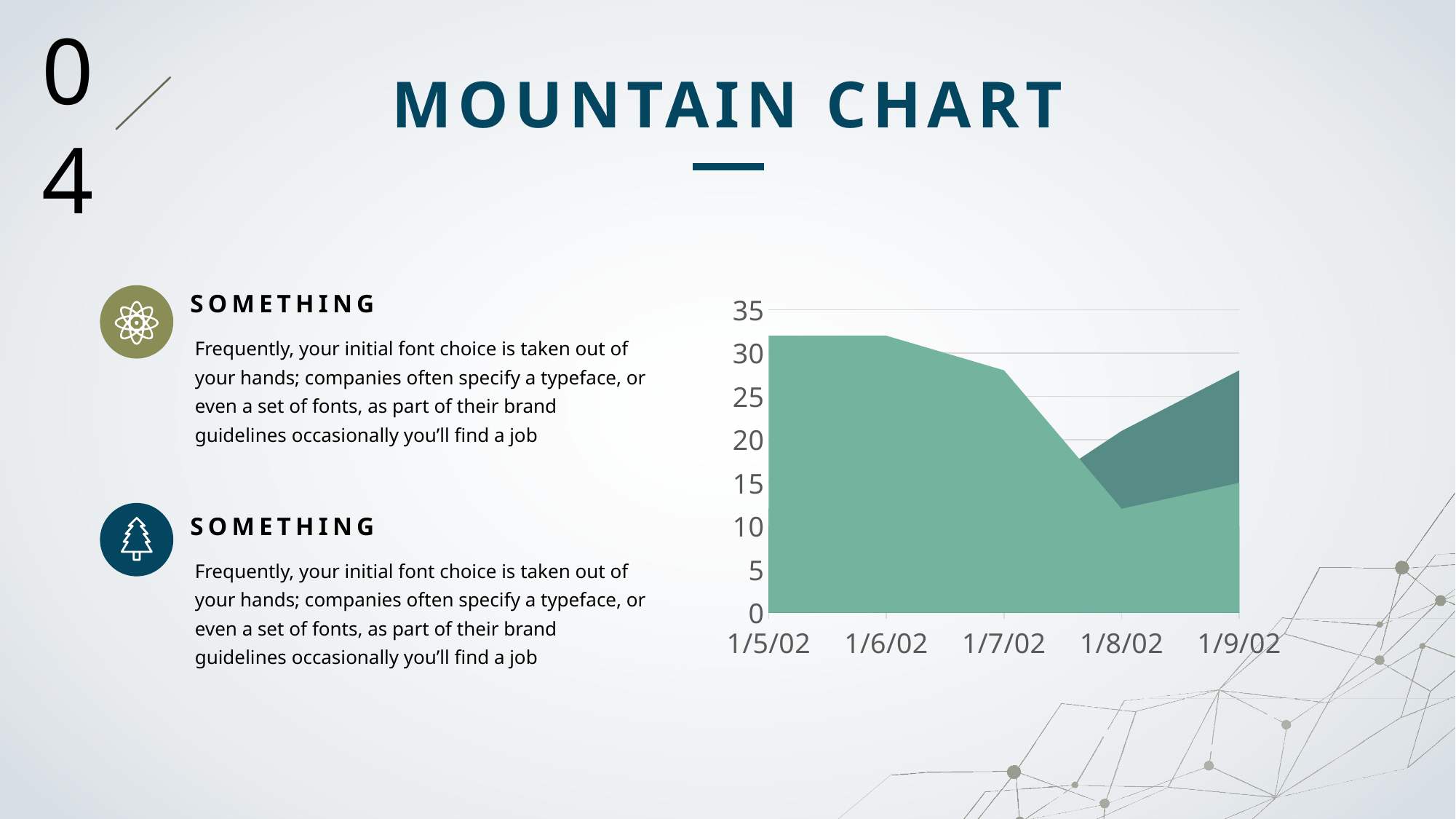
What is the first date label on the x axis of the chart? 1/5/02 Is the value of the dark green area at 1/9/02 greater or less than 25? greater How many dates are labelled along the x axis of the chart? 5 Is the value of the light green area at 1/7/02 greater or less than 25? greater Which date has the lowest value for the light green area? 1/8/02 Is the value of the light green area at 1/5/02 greater or less than 30? greater Which is larger for the light green area: the value at 1/5/02 or the value at 1/8/02? 1/5/02 What kind of chart is shown on the slide? Area chart Does the light green area rise or fall between 1/5/02 and 1/8/02? fall What is the highest tick value shown on the y axis of the chart? 35 What is the title of the slide containing the chart? MOUNTAIN CHART